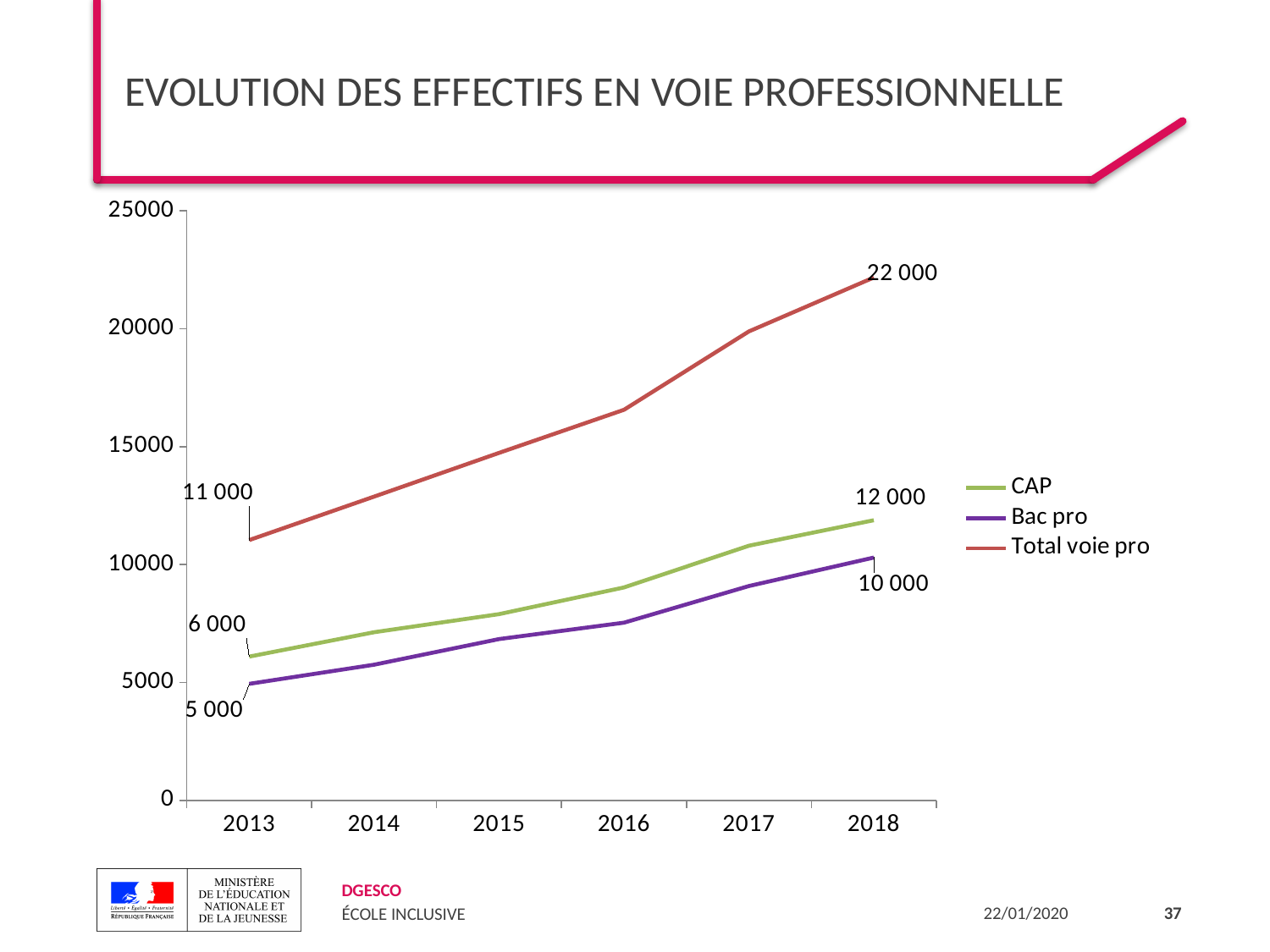
What is the value of Total voie pro in 2018? 22 000 Is the value for Total voie pro in 2016 greater or less than 15000? greater How many series does the legend list? 3 What is the difference between the Total voie pro values in 2018 and 2013? 11 000 What is the value of Bac pro in 2018? 10 000 Does the Bac pro series rise or fall from 2013 to 2018? rise What is the value of Total voie pro in 2013? 11 000 How many years are shown on the x axis? 6 Which series has the highest value in 2018? Total voie pro What type of chart is shown on the slide? line chart What is the difference between CAP and Bac pro in 2018? 2 000 What is the value of CAP in 2013? 6 000